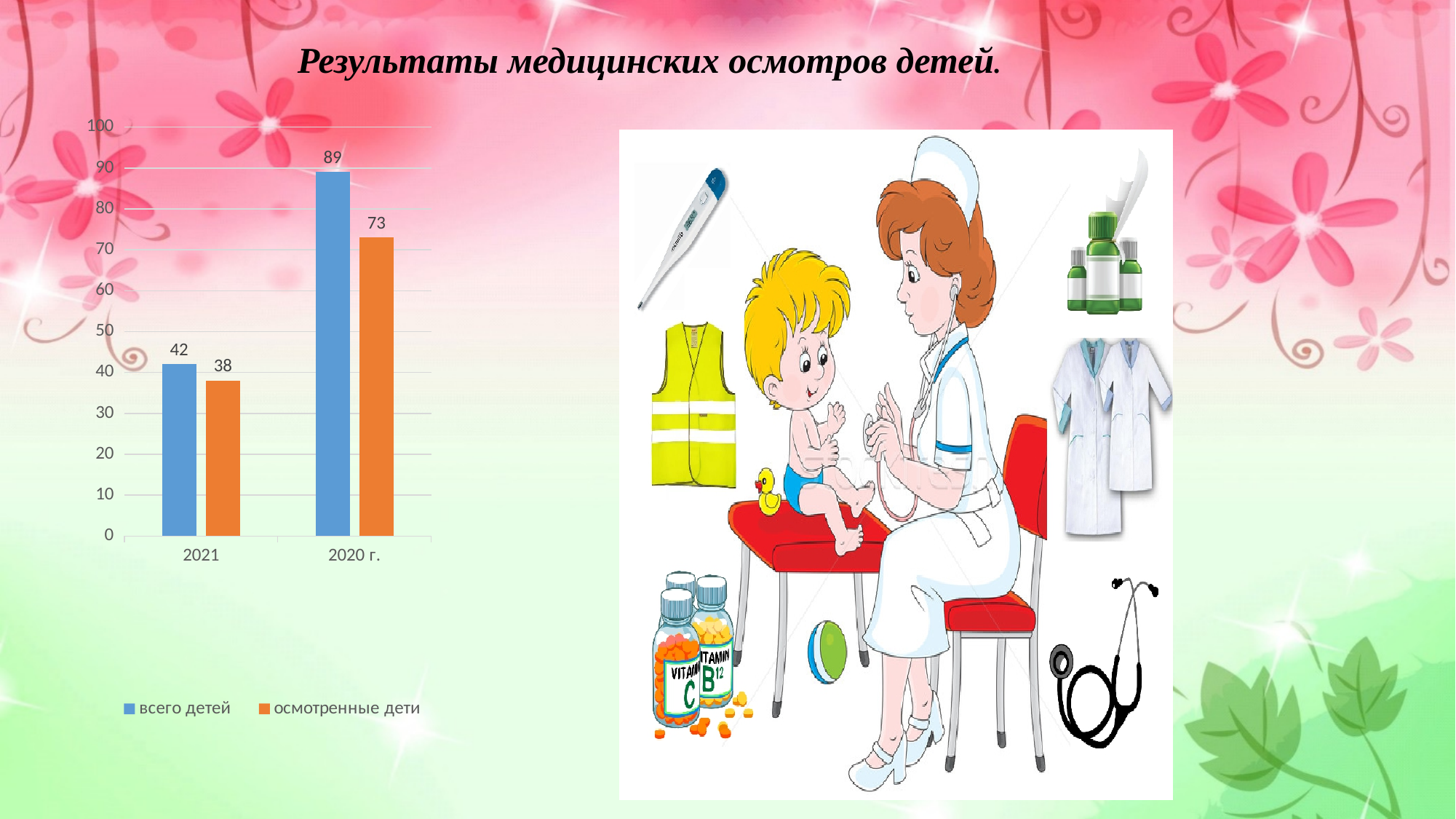
What is the value for 'всего детей' in 2020 г.? 89 How many categories are shown on the x axis? 2 What is the difference between 'всего детей' and 'осмотренные дети' in 2020 г.? 16 What is the difference between 'всего детей' in 2020 г. and in 2021? 47 What kind of chart is shown on the slide? bar chart How many series does the legend list? 2 Which category has the lowest value for 'осмотренные дети'? 2021 What is the value for 'осмотренные дети' in 2021? 38 Which is larger: 'осмотренные дети' in 2021 or 'осмотренные дети' in 2020 г.? 2020 г. What is the value for 'всего детей' in 2021? 42 What is the value for 'осмотренные дети' in 2020 г.? 73 Which category has the highest value for 'всего детей'? 2020 г.